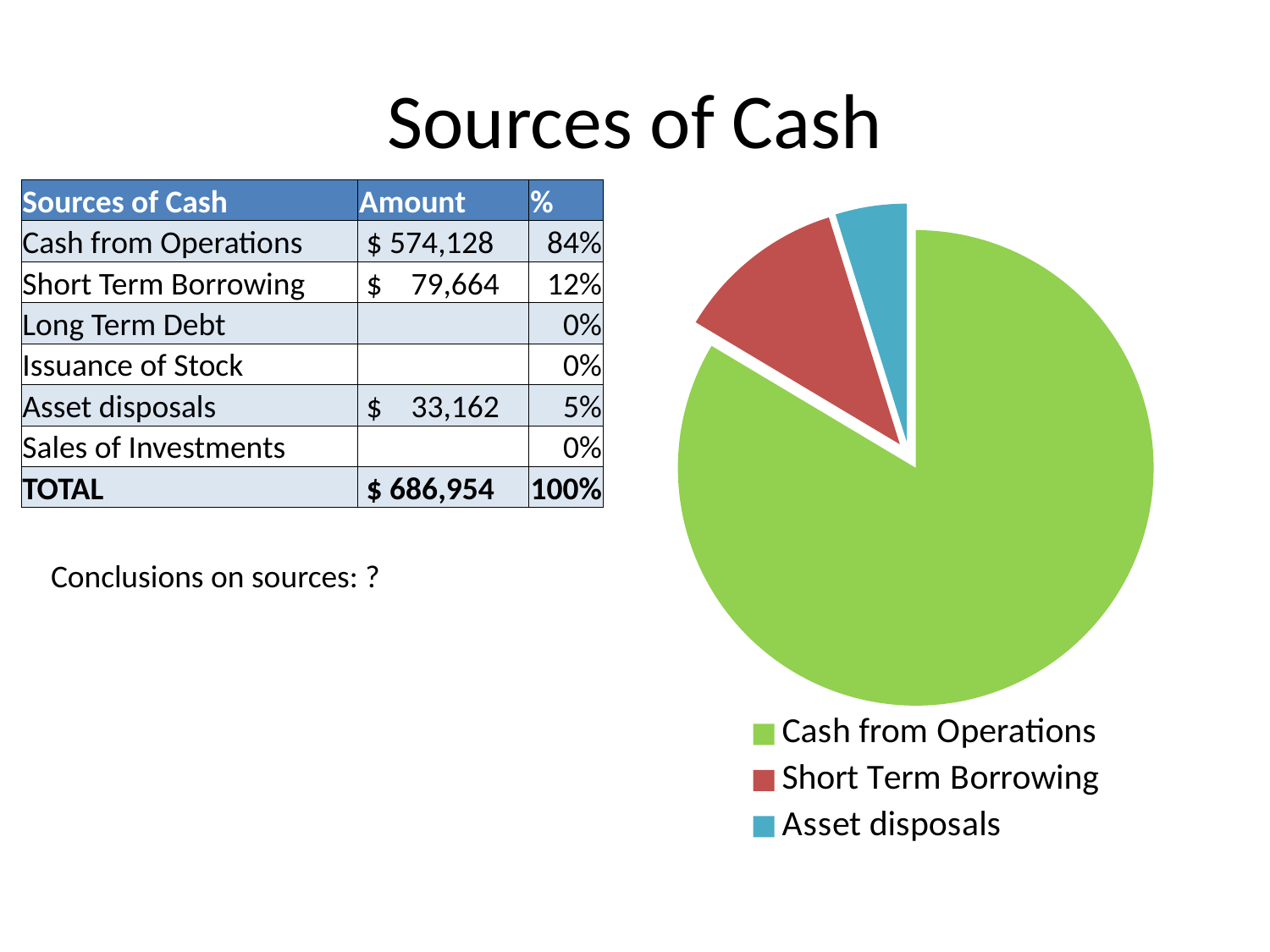
What is the title of the slide containing the pie chart? Sources of Cash What is the amount for Short Term Borrowing shown in the table next to the pie chart? $ 79,664 Which category has the largest slice of the pie chart? Cash from Operations What colour is the Cash from Operations slice in the pie chart? green What share of the pie does Cash from Operations represent, according to the table on the slide? 84% What share of the pie does Asset disposals represent, according to the table on the slide? 5% How many slices does the pie chart have? 3 What share of the pie does Short Term Borrowing represent, according to the table on the slide? 12% Which category has the smallest slice of the pie chart? Asset disposals How many entries does the pie chart's legend list? 3 What kind of chart is shown on the slide? pie chart Which slice is larger in the pie chart, Short Term Borrowing or Asset disposals? Short Term Borrowing